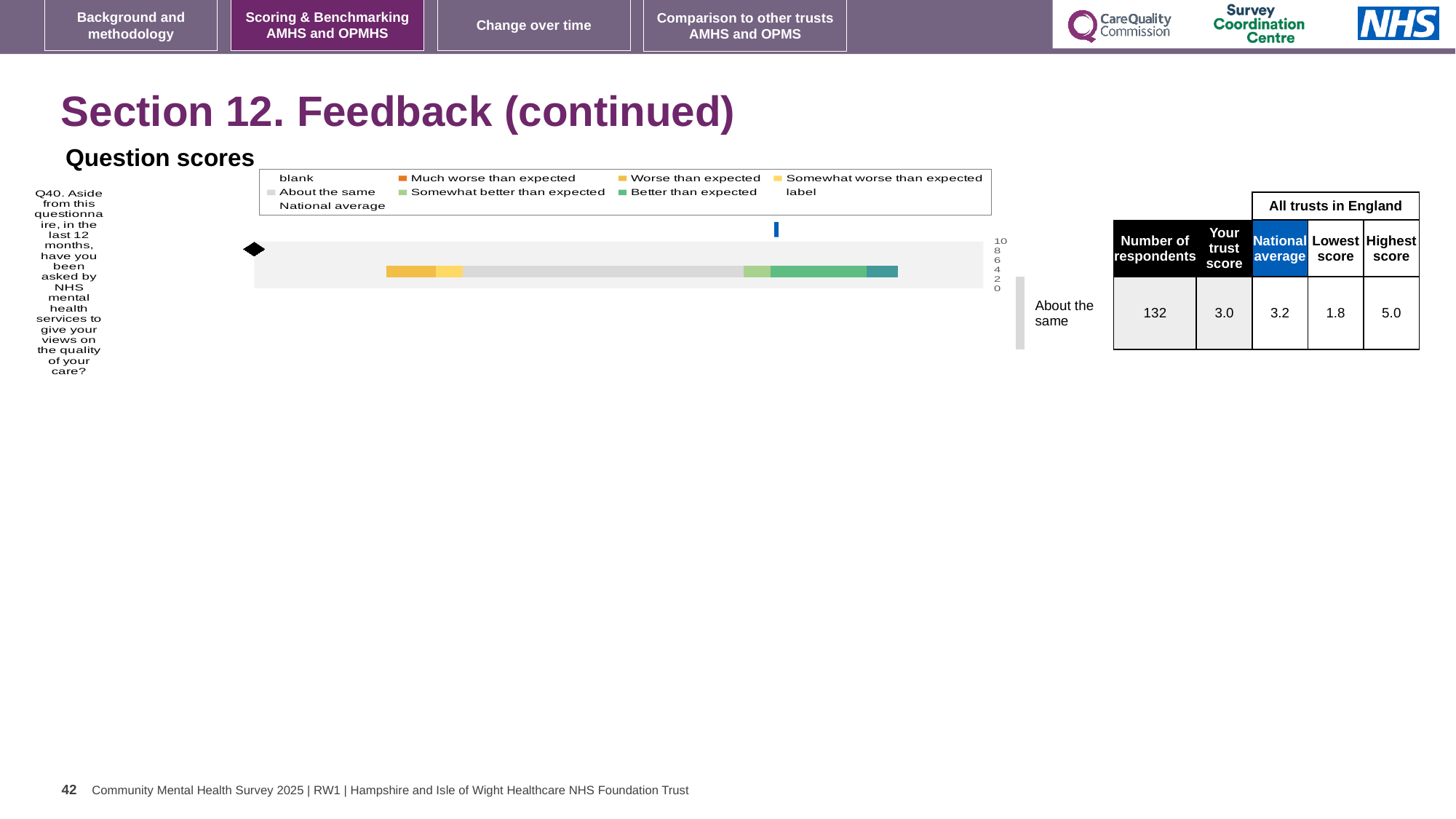
How many entries does the legend of the Question scores chart list? 9 What is the highest tick value shown on the axis of the Question scores chart? 10 In the table beside the chart, what is the National average for Q40? 3.2 For Q40, which is larger: the trust score or the National average? National average In the table beside the chart, what is the Highest score among all trusts in England for Q40? 5.0 In the table beside the chart, what is the Lowest score among all trusts in England for Q40? 1.8 Which question is plotted in the Question scores chart? Q40 In the table beside the chart, what is 'Your trust score' for Q40? 3.0 In the table beside the chart, what is the number of respondents for Q40? 132 How many question categories are plotted in the Question scores chart? 1 For Q40, what is the difference between the Highest score and the Lowest score among all trusts in England? 3.2 What kind of chart is shown under 'Question scores'? bar chart